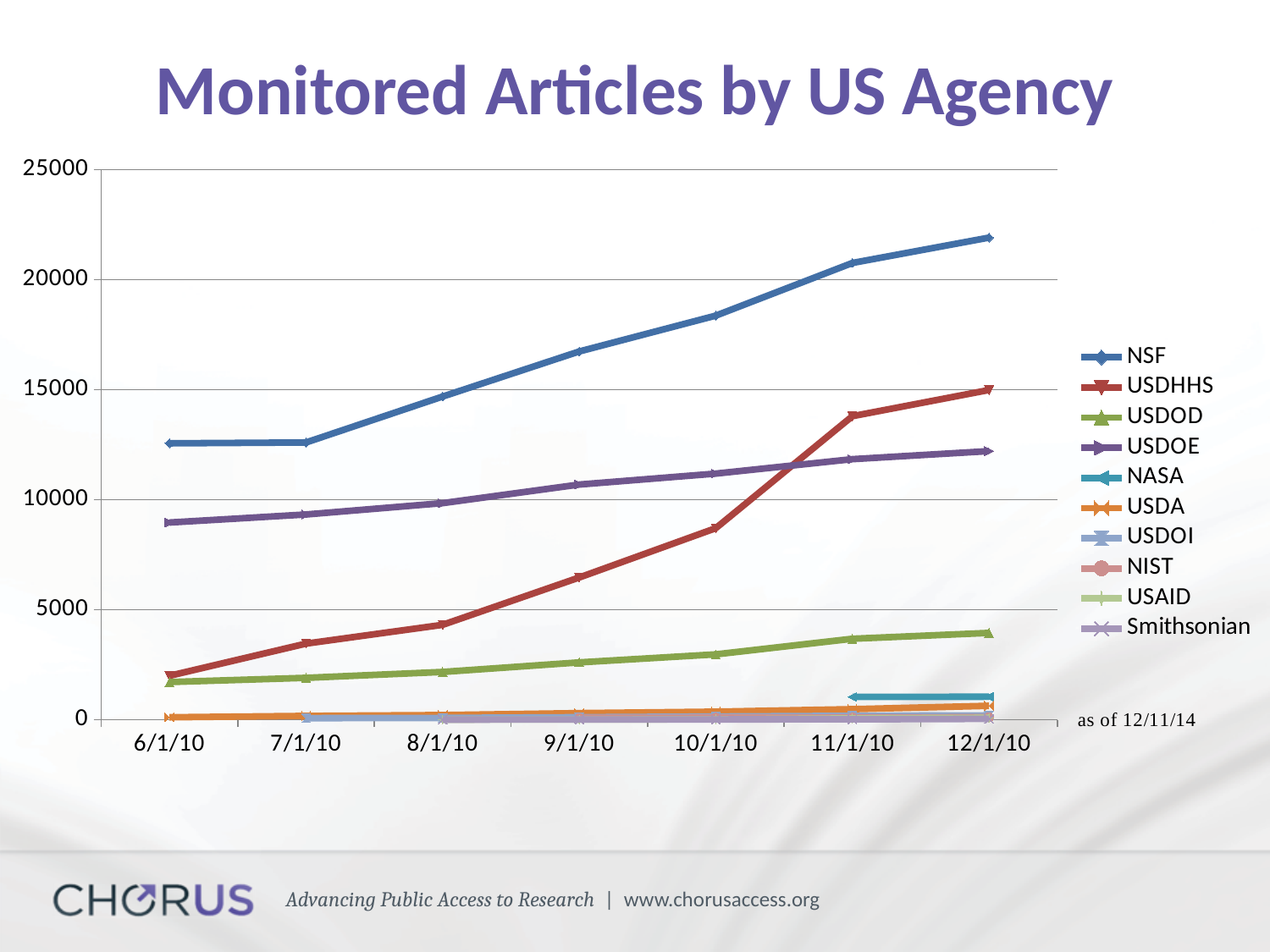
At 12/1/10, which is larger: USDHHS or USDOE? USDHHS Is the value for USDOE at 6/1/10 greater or less than 10000? less Is the value for NSF at 12/1/10 greater or less than 20000? greater Does the NSF line rise or fall from 6/1/10 to 12/1/10? rise What kind of chart is shown on the slide? line chart Is the value for USDHHS at 6/1/10 greater or less than 5000? less Which agency has the highest number of monitored articles at 12/1/10? NSF At 9/1/10, which is larger: USDOE or USDHHS? USDOE How many dates are shown along the x axis? 7 How many series does the legend list? 10 What is the title of the chart? Monitored Articles by US Agency